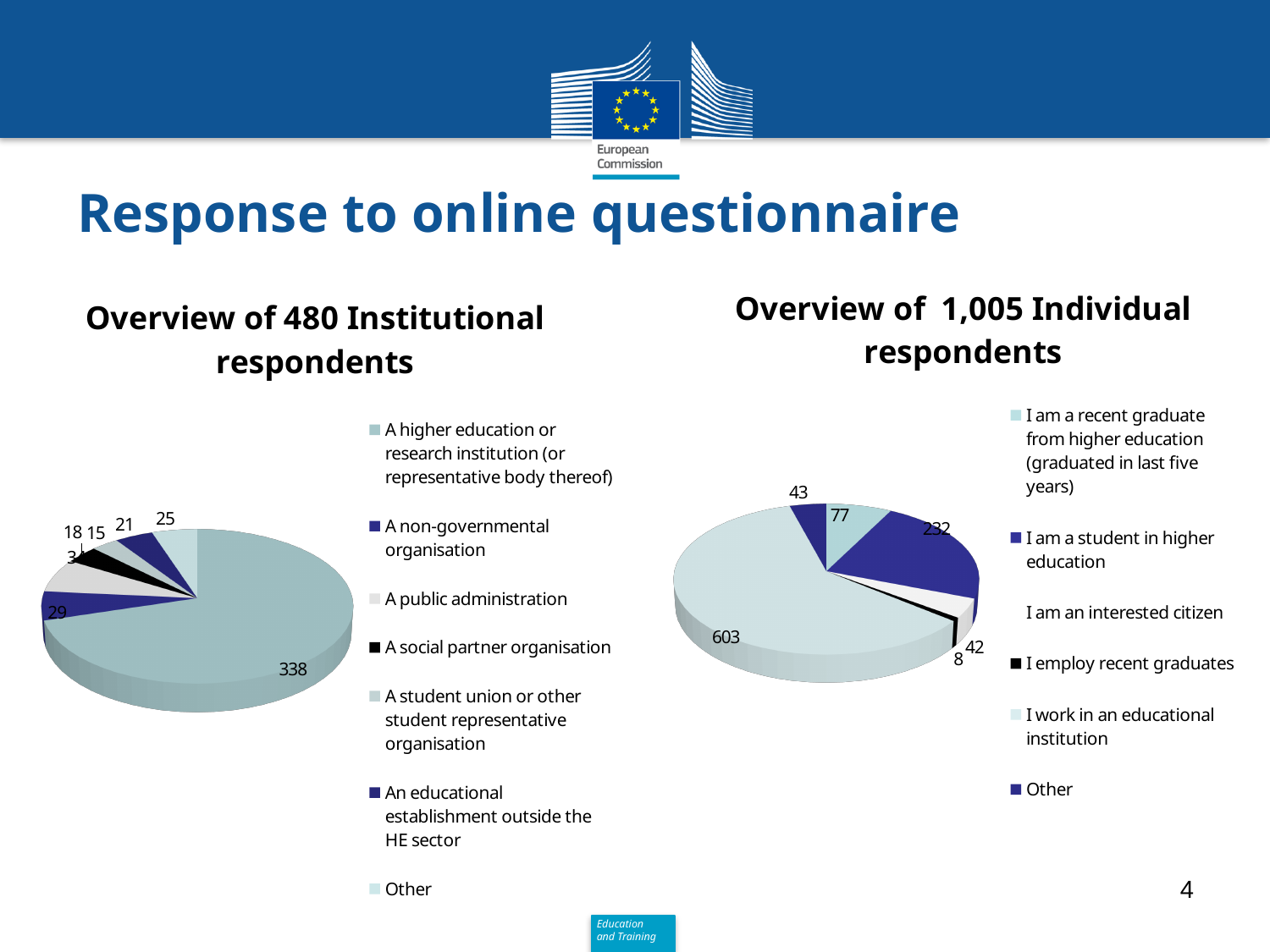
In the Overview of 1,005 Individual respondents chart, which category has the smallest slice? I employ recent graduates In the Overview of 480 Institutional respondents chart, how many respondents are in the Other category? 25 In the Overview of 1,005 Individual respondents chart, what is the difference between the number who work in an educational institution and the number who are students in higher education? 371 In the Overview of 480 Institutional respondents chart, which is larger: a non-governmental organisation or Other? A non-governmental organisation In the Overview of 480 Institutional respondents chart, how many respondents are from a higher education or research institution (or representative body thereof)? 338 How many slices does the Overview of 1,005 Individual respondents pie chart have? 6 In the Overview of 480 Institutional respondents chart, which category has the largest slice? A higher education or research institution (or representative body thereof) What kind of chart is used for the Overview of 480 Institutional respondents? Pie chart In the Overview of 1,005 Individual respondents chart, how many respondents work in an educational institution? 603 In the Overview of 1,005 Individual respondents chart, what share of the 1,005 respondents work in an educational institution? 60% How many categories does the legend of the Overview of 480 Institutional respondents chart list? 7 In the Overview of 1,005 Individual respondents chart, how many respondents are students in higher education? 232